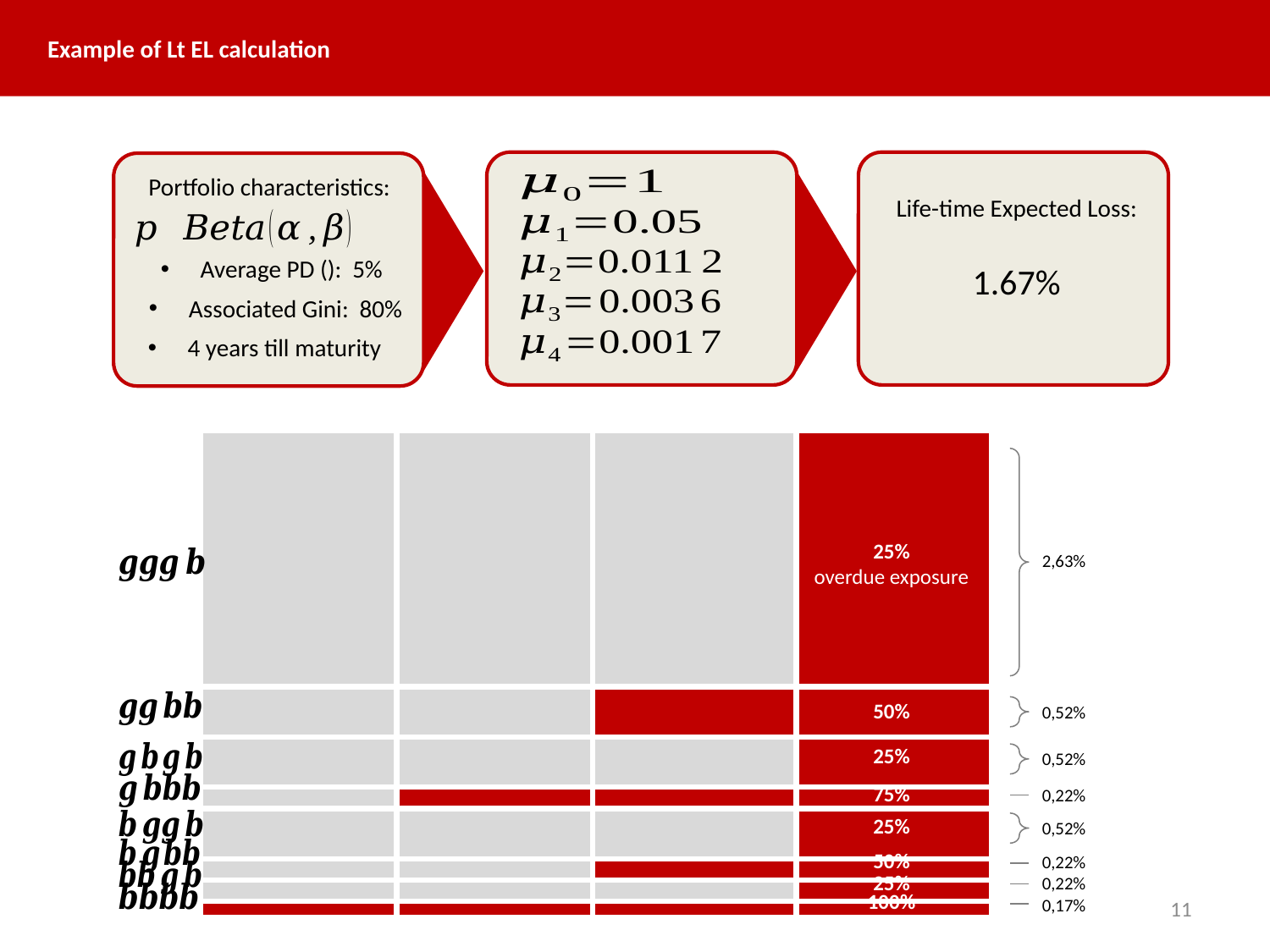
How many scenario rows are shown in the diagram? 8 What value is shown on the right for the gbbb scenario? 0,22% What overdue exposure percentage is shown for the gbbb scenario? 75% What value is shown on the right for the ggbb scenario? 0,52% Which has the larger right-hand value, gggb or gbgb? gggb What value is shown on the right for the gggb scenario? 2,63% Which scenario has the highest value shown on the right? gggb What overdue exposure percentage is shown for the ggbb scenario? 50% Which scenario has the lowest value shown on the right? bbbb What overdue exposure percentage is shown for the gggb scenario? 25% What overdue exposure percentage is shown for the bggb scenario? 25% What is the difference between the right-hand values for gggb and ggbb? 2,11%